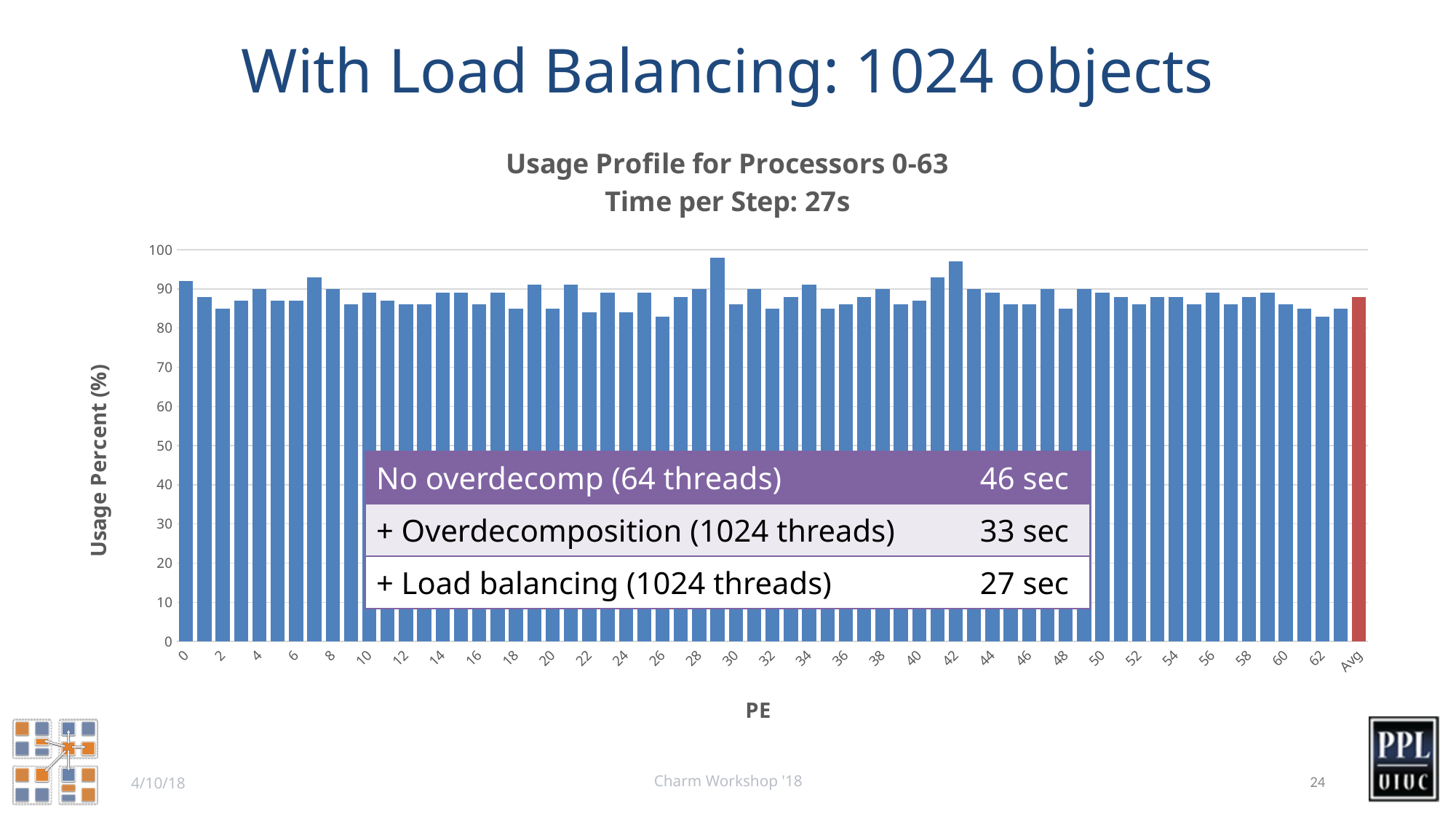
Is the usage value for PE 62 greater or less than 90? less Which has the higher usage value, PE 42 or PE 62? PE 42 Is the usage value for PE 10 greater or less than 80? greater Is the usage value for the Avg bar greater or less than 90? less What is the label of the y axis of the chart? Usage Percent (%) Which has the higher usage value, PE 29 or PE 26? PE 29 What is the title of the chart? Usage Profile for Processors 0-63 Time per Step: 27s What kind of chart is shown on the slide? bar chart How many processor (PE) bars are plotted in the chart, excluding the Avg bar? 64